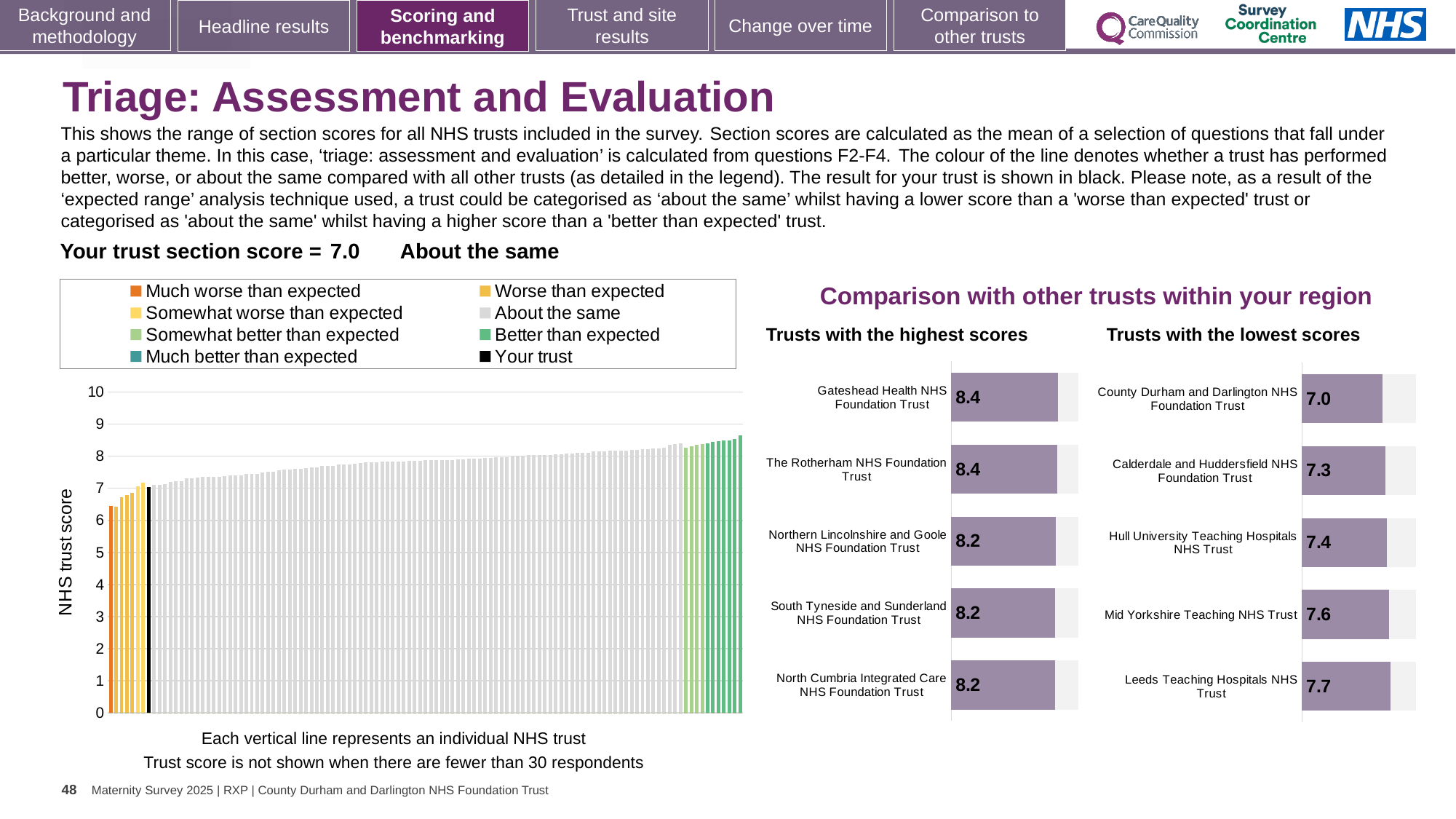
In the main 'NHS trust score' chart, is the value of the highest bar greater or less than 9? less In the 'Trusts with the highest scores' chart, what is the difference between the scores of The Rotherham NHS Foundation Trust and South Tyneside and Sunderland NHS Foundation Trust? 0.2 In the 'Trusts with the lowest scores' chart, which trust has the highest score? Leeds Teaching Hospitals NHS Trust In the 'Trusts with the lowest scores' chart, which has the larger score: Calderdale and Huddersfield NHS Foundation Trust or Mid Yorkshire Teaching NHS Trust? Mid Yorkshire Teaching NHS Trust In the 'Trusts with the highest scores' chart, what is the score for Gateshead Health NHS Foundation Trust? 8.4 In the 'Trusts with the highest scores' chart, what is the score for North Cumbria Integrated Care NHS Foundation Trust? 8.2 In the main 'NHS trust score' chart, do the bar values rise or fall from left to right? rise How many trusts are listed in the 'Trusts with the highest scores' chart? 5 In the 'Trusts with the lowest scores' chart, what is the score for Hull University Teaching Hospitals NHS Trust? 7.4 How many entries does the legend of the main 'NHS trust score' chart list? 8 In the 'Trusts with the lowest scores' chart, which trust has the lowest score? County Durham and Darlington NHS Foundation Trust In the 'Trusts with the lowest scores' chart, what is the difference between the scores of Leeds Teaching Hospitals NHS Trust and County Durham and Darlington NHS Foundation Trust? 0.7